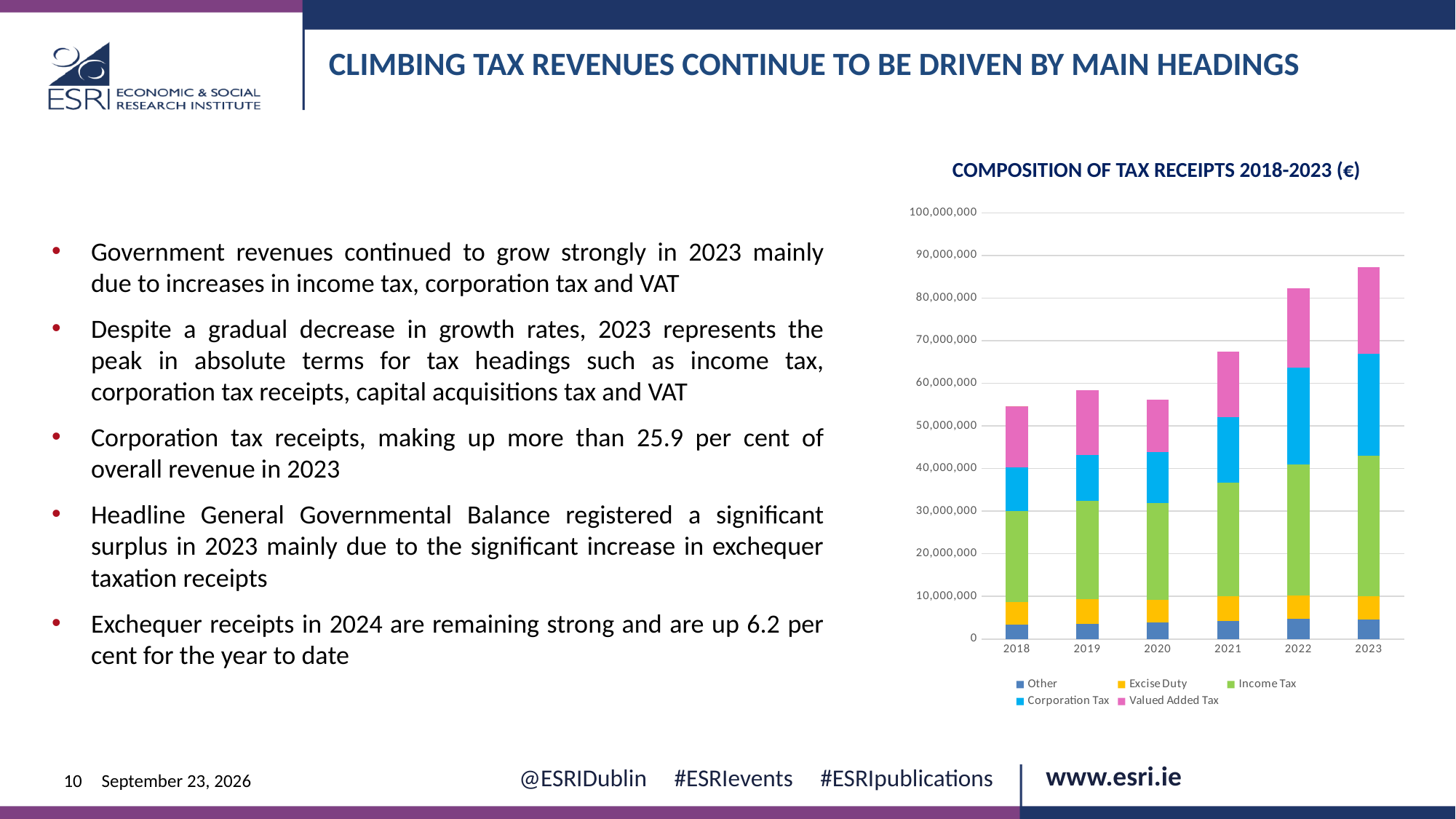
How many series does the chart legend list? 5 Is the total tax receipts bar for 2023 greater or less than 80,000,000? greater What is the title of the chart? COMPOSITION OF TAX RECEIPTS 2018-2023 (€) Is the total tax receipts bar for 2021 greater or less than 70,000,000? less How many years (categories) are shown on the x axis of the chart? 6 Do the total tax receipts generally rise or fall from 2018 to 2023? rise Which year has the larger total tax receipts, 2018 or 2023? 2023 Which year has the highest total tax receipts in the chart? 2023 Which series is shown in green in the chart? Income Tax What kind of chart is shown on the slide? stacked bar chart Is the total tax receipts bar for 2022 greater or less than 70,000,000? greater